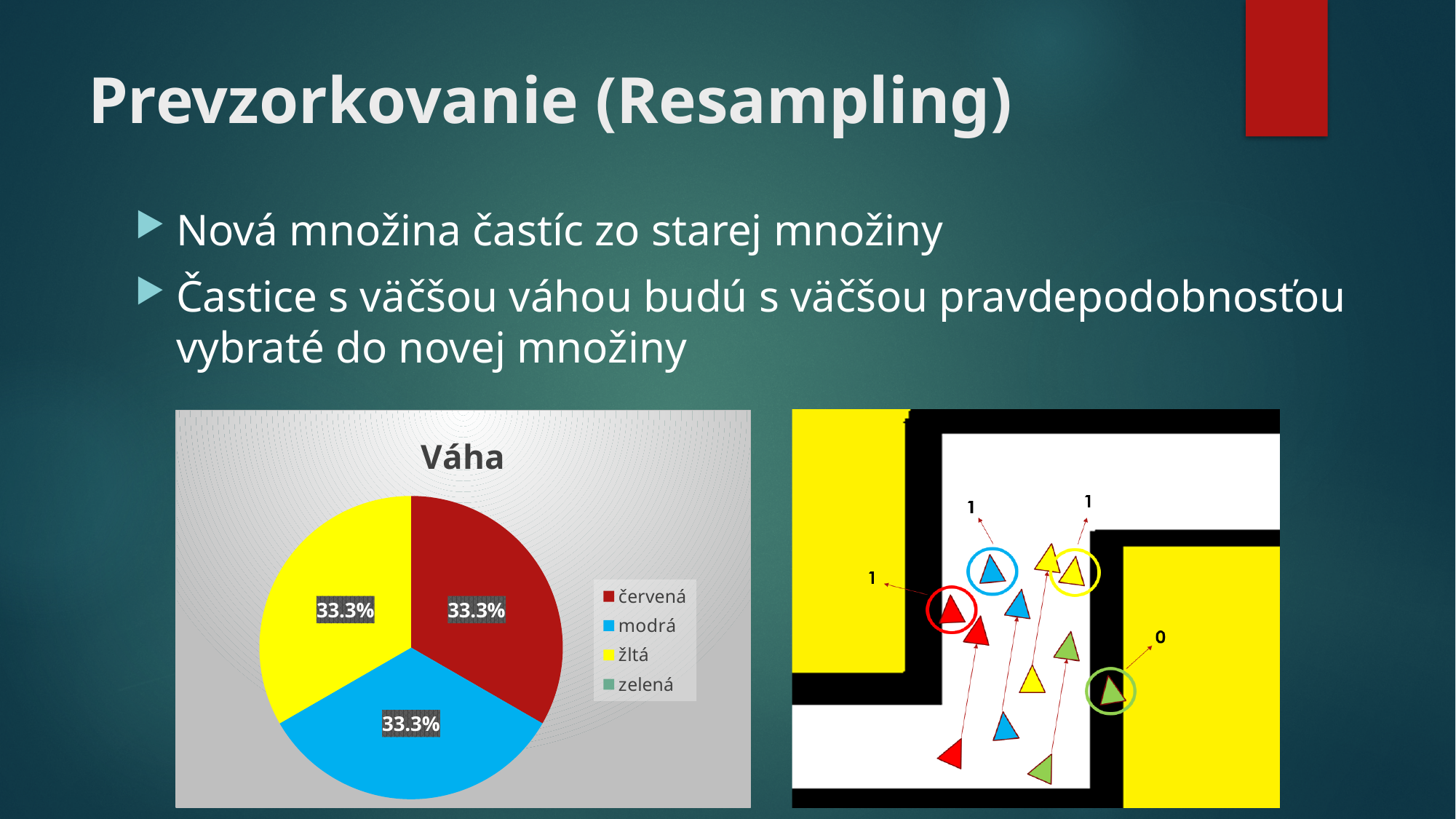
What is the title of the pie chart? Váha How many slices with data labels are visible in the pie chart? 3 What is the difference between the červená and modrá shares in the pie chart? 0.0% What share of the pie chart does the modrá slice have? 33.3% What share of the pie chart does the žltá slice have? 33.3% Which legend entry of the pie chart has no visible slice? zelená What kind of chart is shown on the left of the slide? pie chart What share of the pie chart does the červená slice have? 33.3% How many entries does the legend of the pie chart list? 4 Is the share of the žltá slice in the pie chart greater or less than 30%? greater